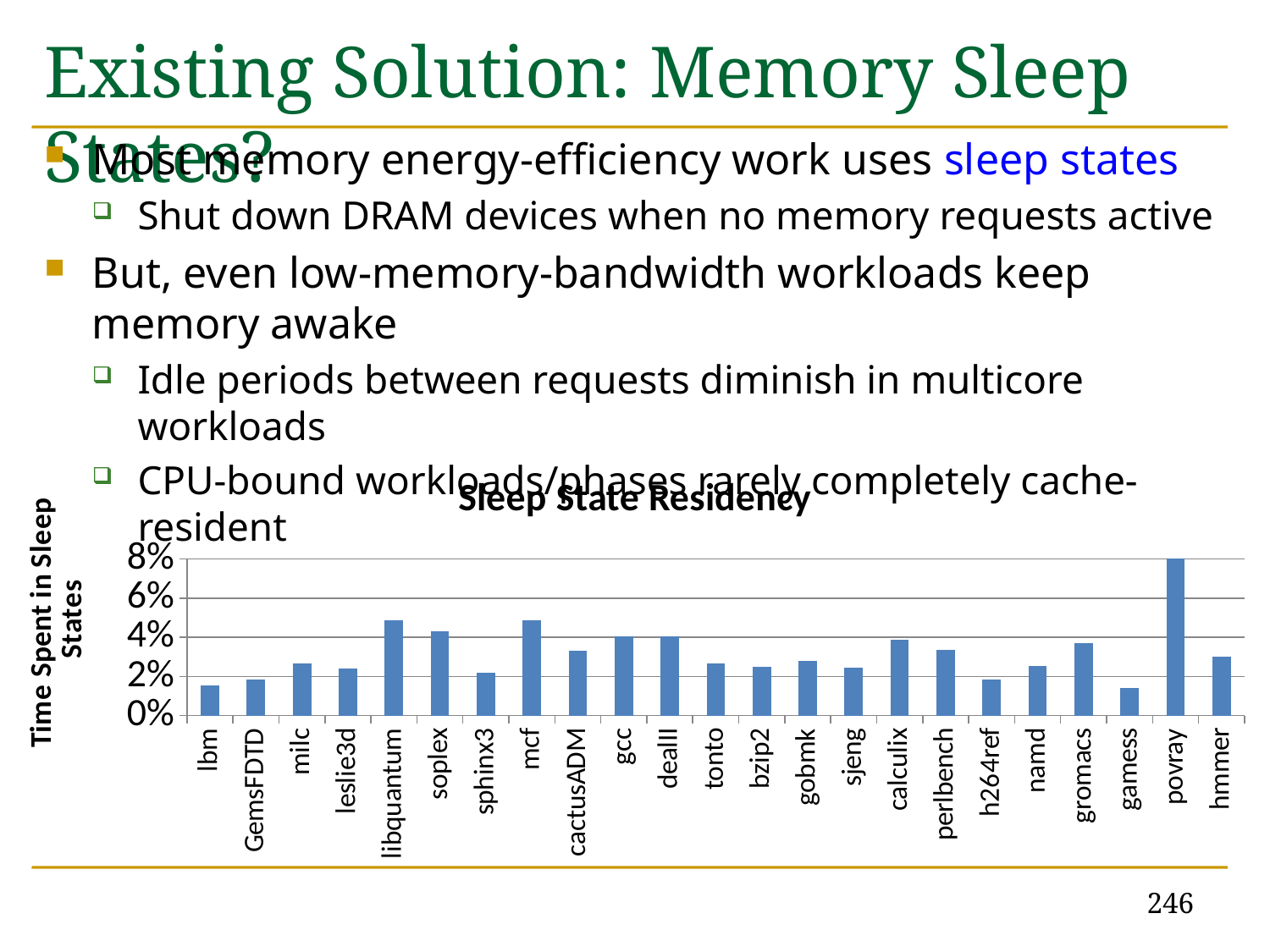
What kind of chart is shown on the slide? bar chart What is the label on the vertical axis of the chart? Time Spent in Sleep States Which workload has the highest time spent in sleep states? povray Which has a higher value, povray or hmmer? povray Is the value for libquantum greater or less than 4%? greater How many workloads (categories) are plotted in the chart? 23 Is the value for povray greater or less than 6%? greater Which has a higher value, gamess or gromacs? gromacs Is the value for gamess greater or less than 2%? less What is the title of the chart? Sleep State Residency Which has a higher value, libquantum or sphinx3? libquantum